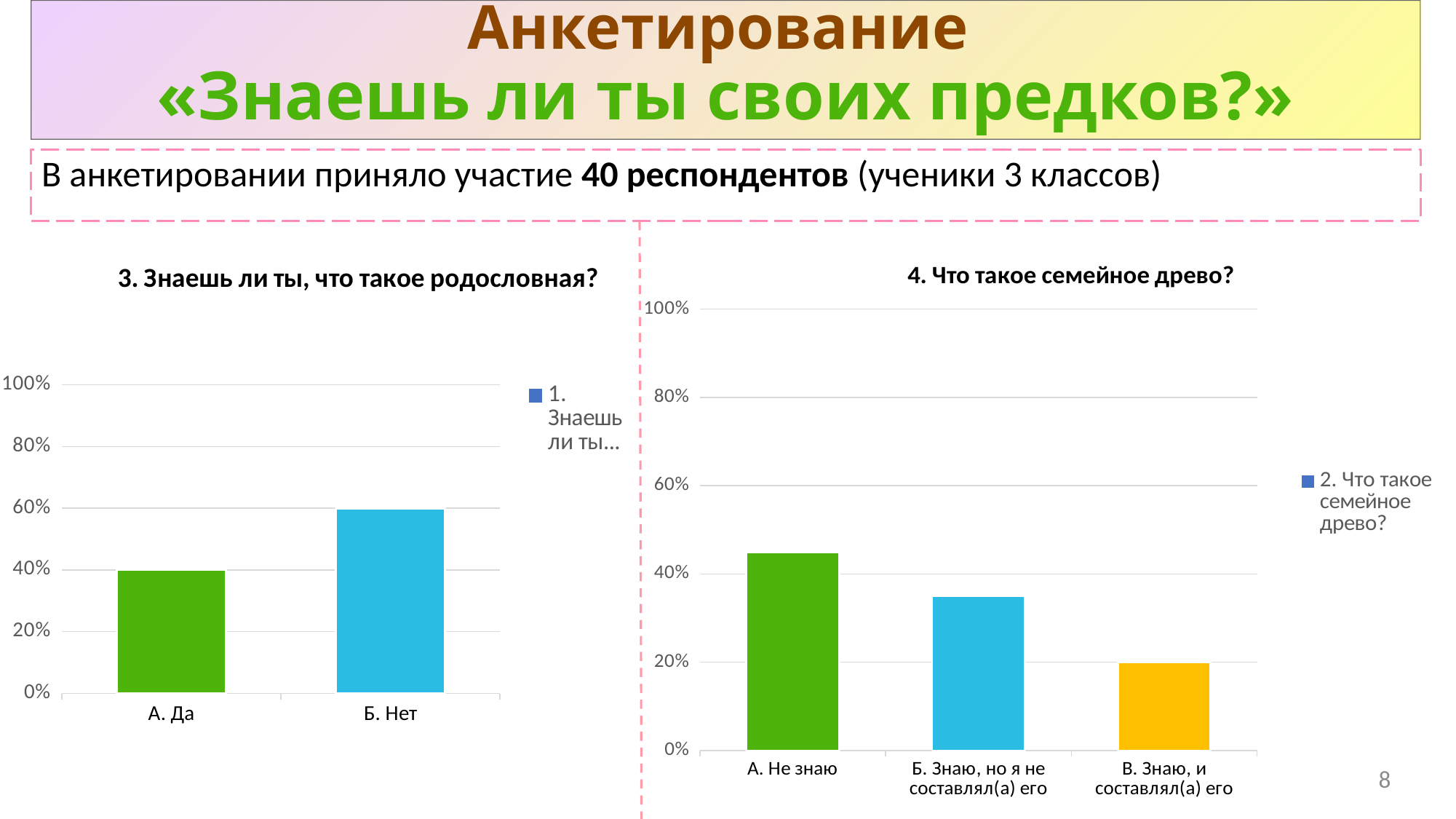
In the left chart «3. Знаешь ли ты, что такое родословная?», which category has the highest value? Б. Нет In the left chart «3. Знаешь ли ты, что такое родословная?», what is the value for Б. Нет? 60% In the right chart «4. Что такое семейное древо?», which category has the lowest value? В. Знаю, и составлял(а) его In the right chart «4. Что такое семейное древо?», do the values rise or fall from left to right along the x axis? fall In the right chart «4. Что такое семейное древо?», is the value for А. Не знаю greater or less than 40%? greater In the right chart «4. Что такое семейное древо?», how many categories are shown? 3 In the right chart «4. Что такое семейное древо?», which category has the highest value? А. Не знаю In the right chart «4. Что такое семейное древо?», is the value for Б. Знаю, но я не составлял(а) его greater or less than 40%? less In the left chart «3. Знаешь ли ты, что такое родословная?», how many categories are shown? 2 In the right chart «4. Что такое семейное древо?», what colour is the bar for В. Знаю, и составлял(а) его? yellow In the left chart «3. Знаешь ли ты, что такое родословная?», what is the value for А. Да? 40% What kind of chart is the left chart titled «3. Знаешь ли ты, что такое родословная?»? bar chart